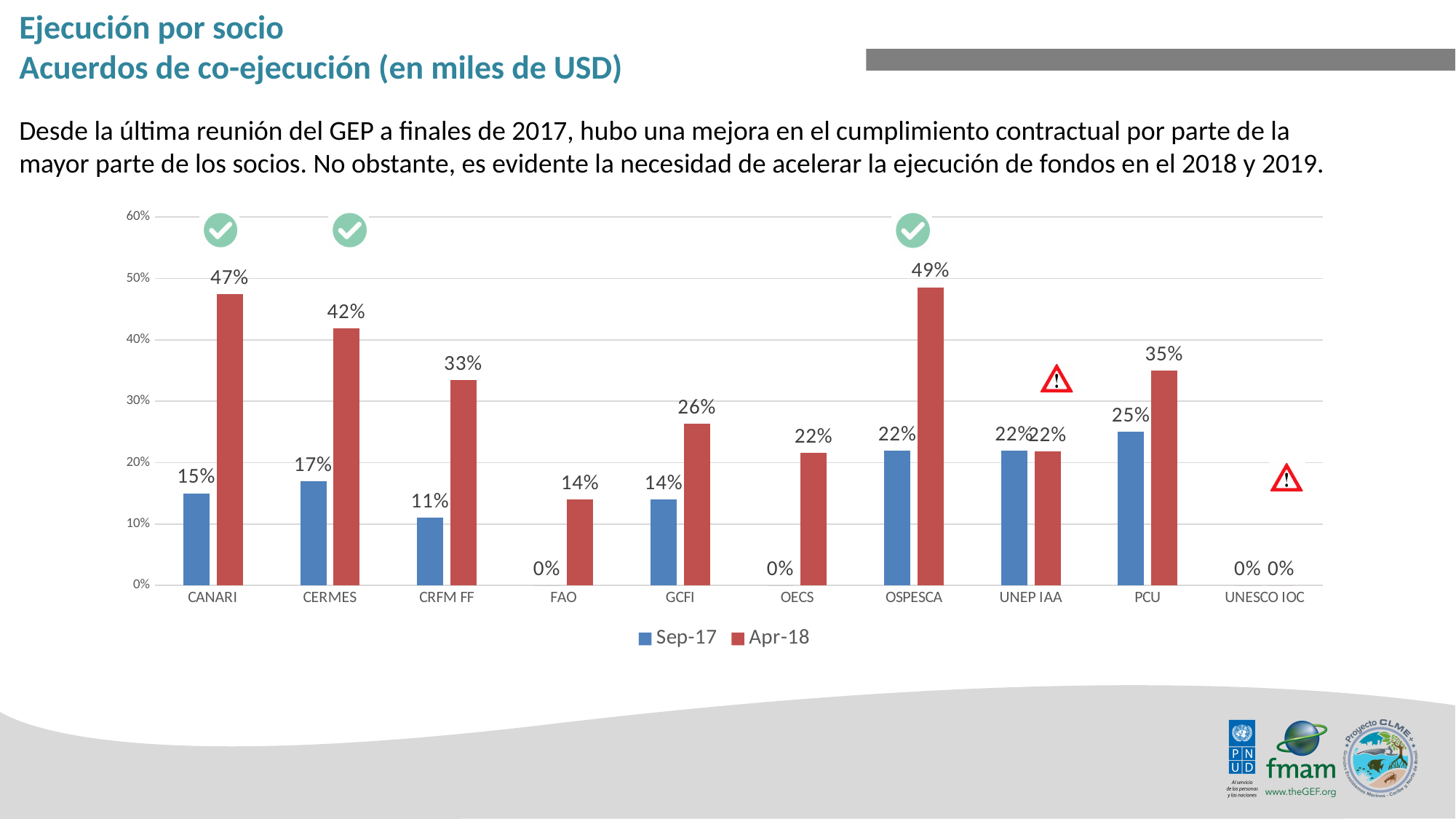
What is the Sep-17 value for CERMES? 17% What is the Apr-18 value for UNESCO IOC? 0% Which category has the highest Apr-18 value? OSPESCA How many categories are shown on the x axis? 10 What is the Apr-18 value for GCFI? 26% What is the Apr-18 value for CANARI? 47% How many series does the legend list? 2 What is the difference between the Apr-18 and Sep-17 values for CRFM FF? 22% Which category has the highest Sep-17 value? PCU What are the two series listed in the legend? Sep-17 and Apr-18 What kind of chart is shown on the slide? Bar chart Which is larger for PCU, the Sep-17 value or the Apr-18 value? Apr-18